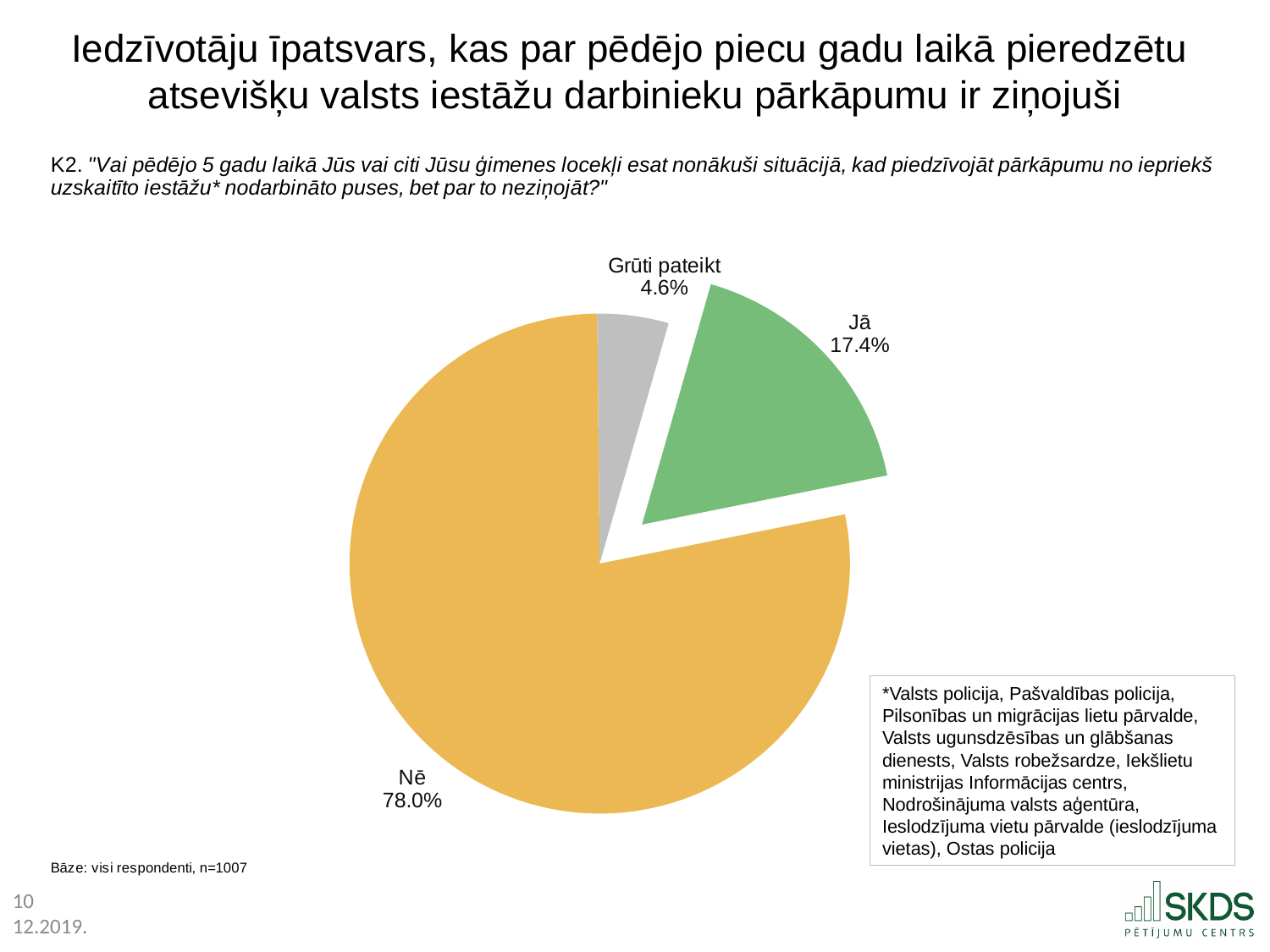
What is the difference in percentage points between "Nē" and "Jā"? 60.6 What is the base (number of respondents) stated on the slide? n=1007 What colour is the "Jā" slice of the pie? green Which response has the smallest share of the pie? Grūti pateikt Which is larger, the share for "Jā" or the share for "Grūti pateikt"? Jā Which response has the largest share of the pie? Nē What type of chart is shown on the slide? pie chart What percentage of respondents answered "Jā"? 17.4% How many slices does the pie chart have? 3 What is the difference in percentage points between "Jā" and "Grūti pateikt"? 12.8 What percentage of respondents answered "Grūti pateikt"? 4.6% What percentage of respondents answered "Nē"? 78.0%